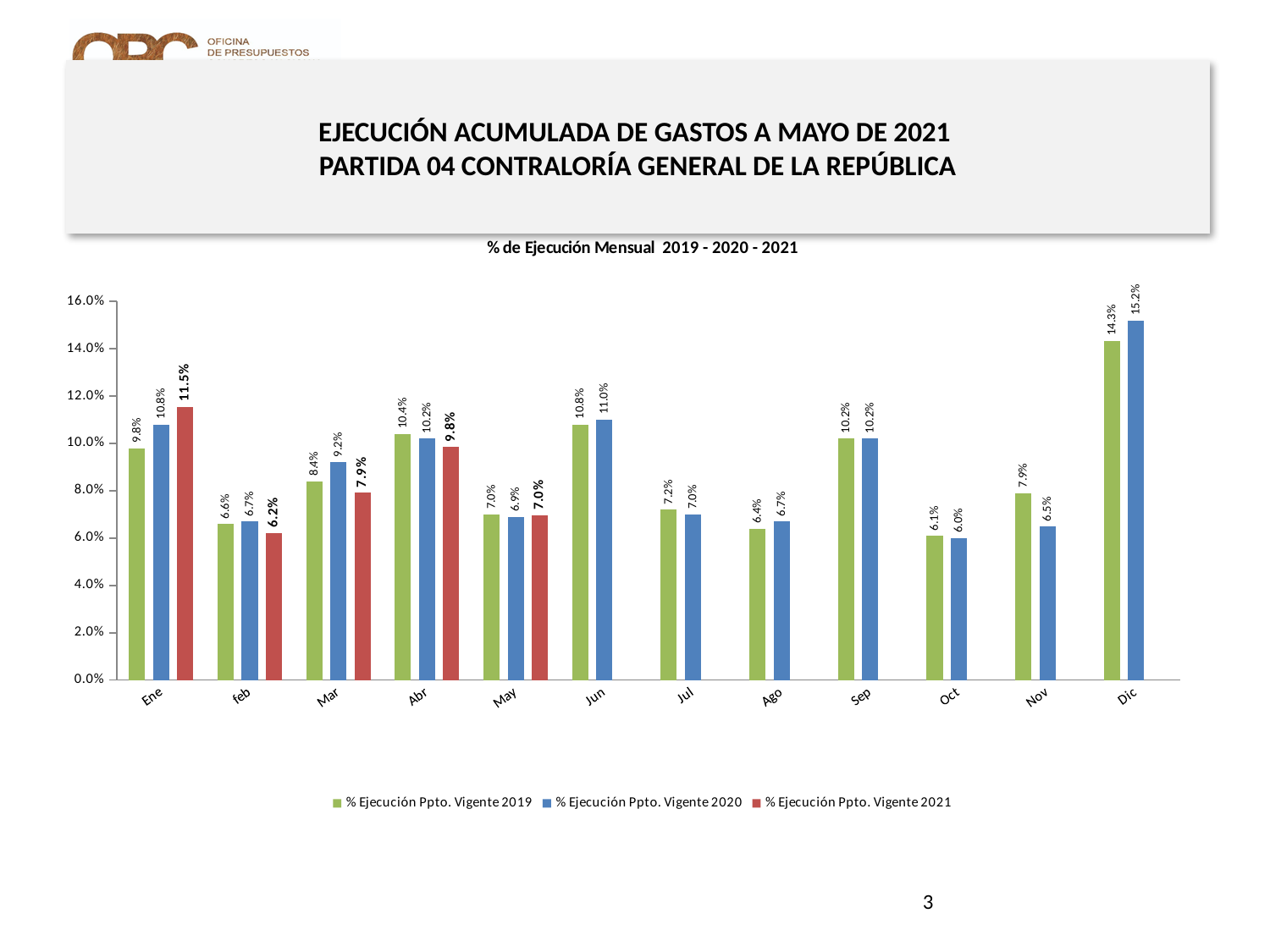
How many series does the legend list? 3 Which month has the lowest value for % Ejecución Ppto. Vigente 2020? Oct What is the value for % Ejecución Ppto. Vigente 2020 in Dic? 15.2% How many months are shown on the x axis? 12 What kind of chart is shown? Bar chart Which month has the highest value for % Ejecución Ppto. Vigente 2019? Dic Is the value for % Ejecución Ppto. Vigente 2019 in Nov greater or less than 8.0%? less What is the value for % Ejecución Ppto. Vigente 2021 in Ene? 11.5% What is the difference between the 2020 and 2019 values in Dic? 0.9% What colour represents % Ejecución Ppto. Vigente 2021? Red What is the value for % Ejecución Ppto. Vigente 2019 in Abr? 10.4% Which is larger in Mar: the 2020 value or the 2021 value? 2020